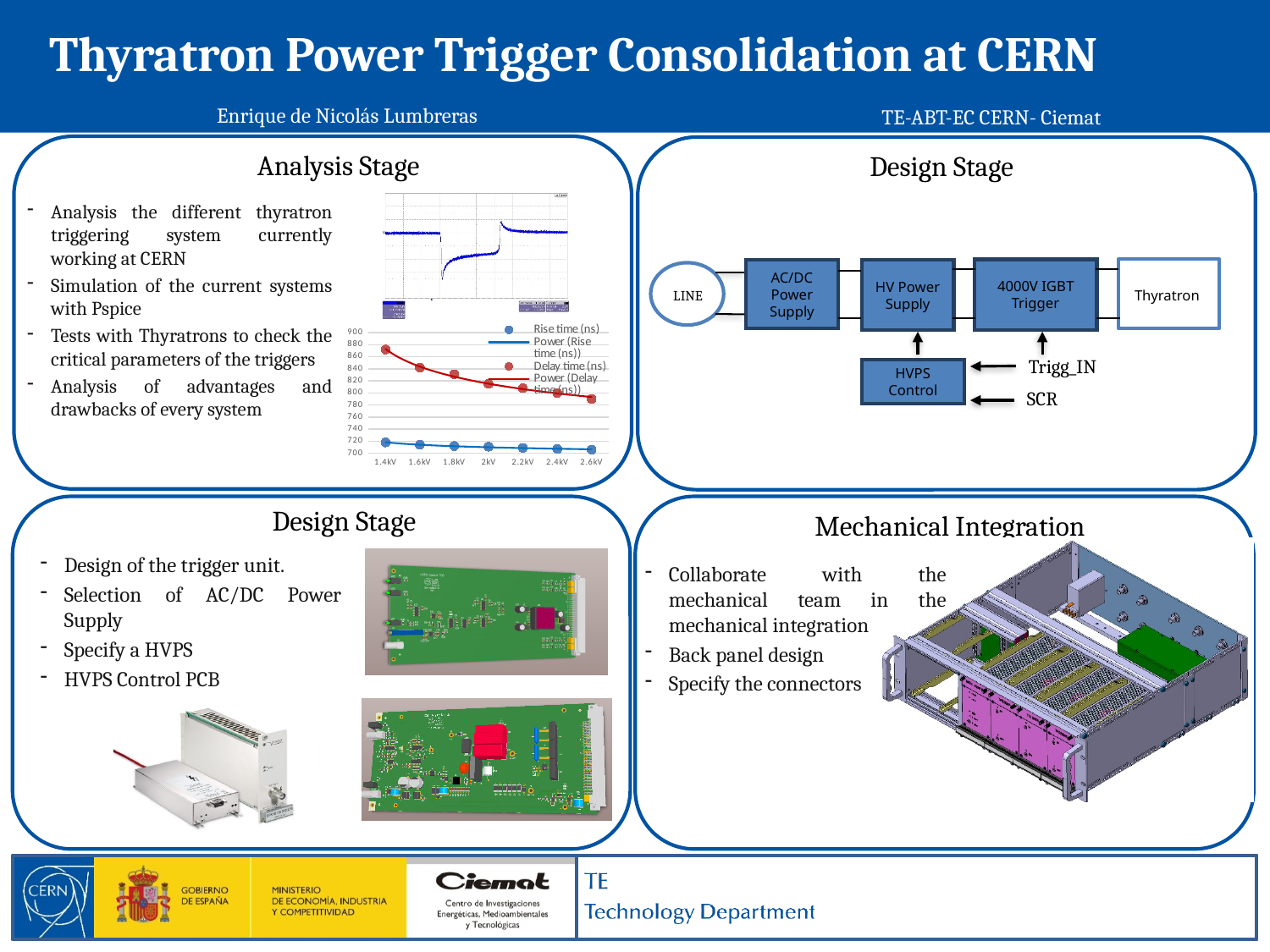
What is the highest value shown on the y axis of the chart in the Analysis Stage section? 900 In the Analysis Stage chart, does the Delay time (ns) rise or fall as the voltage increases from 1.4kV to 2.6kV? Fall How many series does the legend of the chart in the Analysis Stage section list? 4 In the Analysis Stage chart, which is larger at 1.4kV, the Delay time (ns) or the Rise time (ns)? Delay time (ns) In the Analysis Stage chart, at which voltage is the Delay time (ns) highest? 1.4kV In the Analysis Stage chart, is the Delay time (ns) at 1.4kV greater or less than 840? greater In the Analysis Stage chart, is the Rise time (ns) at 1.4kV greater or less than 740? less In the Analysis Stage chart, is the Rise time (ns) at 2.6kV greater or less than 720? less In the Analysis Stage chart, at which voltage is the Delay time (ns) lowest? 2.6kV What kind of chart is shown in the Analysis Stage section? Scatter chart How many voltage points are shown along the x axis of the chart in the Analysis Stage section? 7